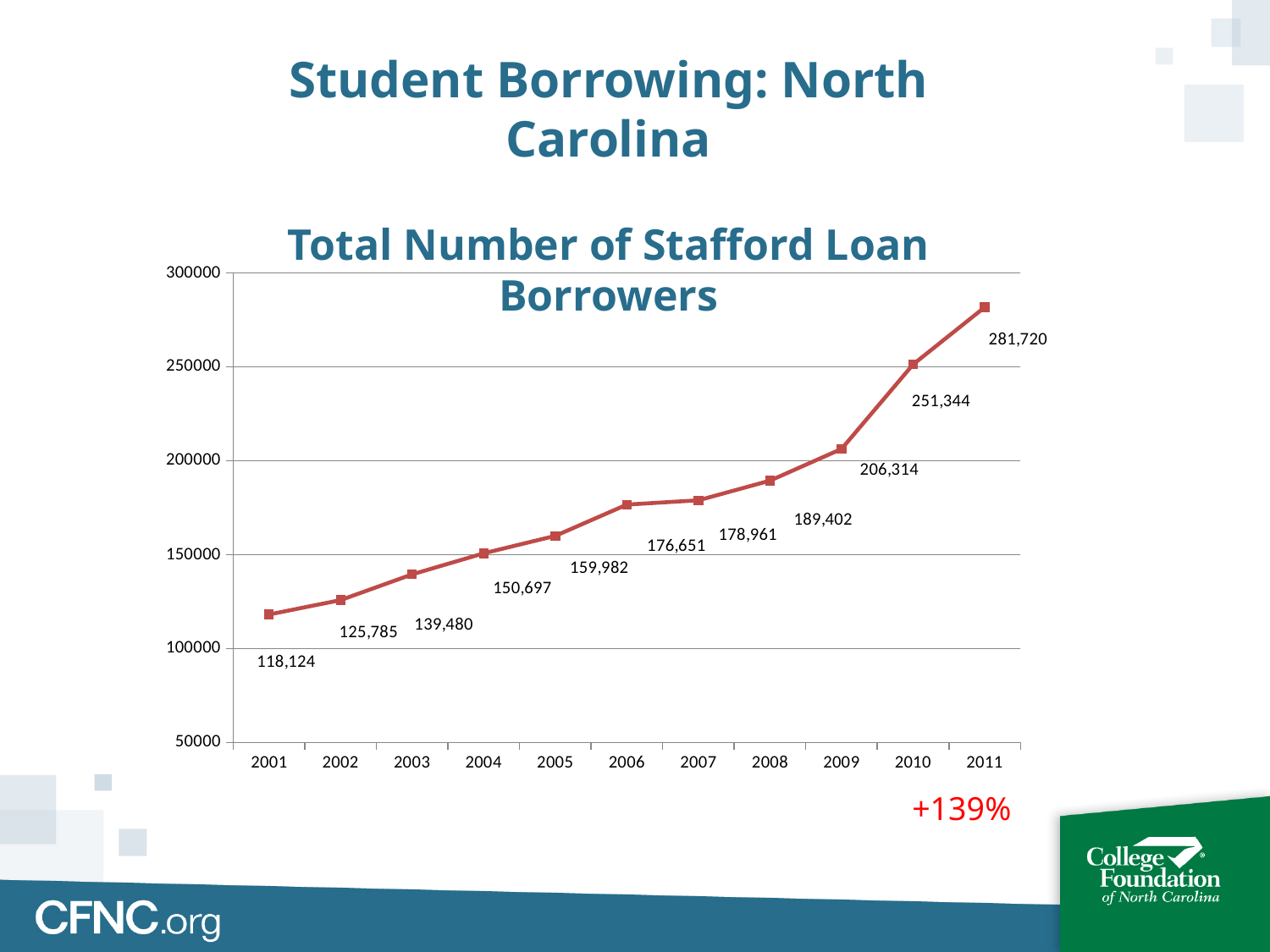
What kind of chart is shown on the slide? Line chart What is the total number of Stafford Loan borrowers in 2006? 176,651 How many years are plotted on the chart? 11 Does the number of Stafford Loan borrowers rise or fall from 2001 to 2011? Rise Is the number of Stafford Loan borrowers in 2009 greater or less than 200000? greater What is the total number of Stafford Loan borrowers in 2011? 281,720 What is the difference in the number of Stafford Loan borrowers between 2009 and 2008? 16,912 Which year has the lowest number of Stafford Loan borrowers? 2001 What is the total number of Stafford Loan borrowers in 2001? 118,124 Which year had more Stafford Loan borrowers, 2004 or 2007? 2007 Which year has the highest number of Stafford Loan borrowers? 2011 What is the difference in the number of Stafford Loan borrowers between 2011 and 2010? 30,376